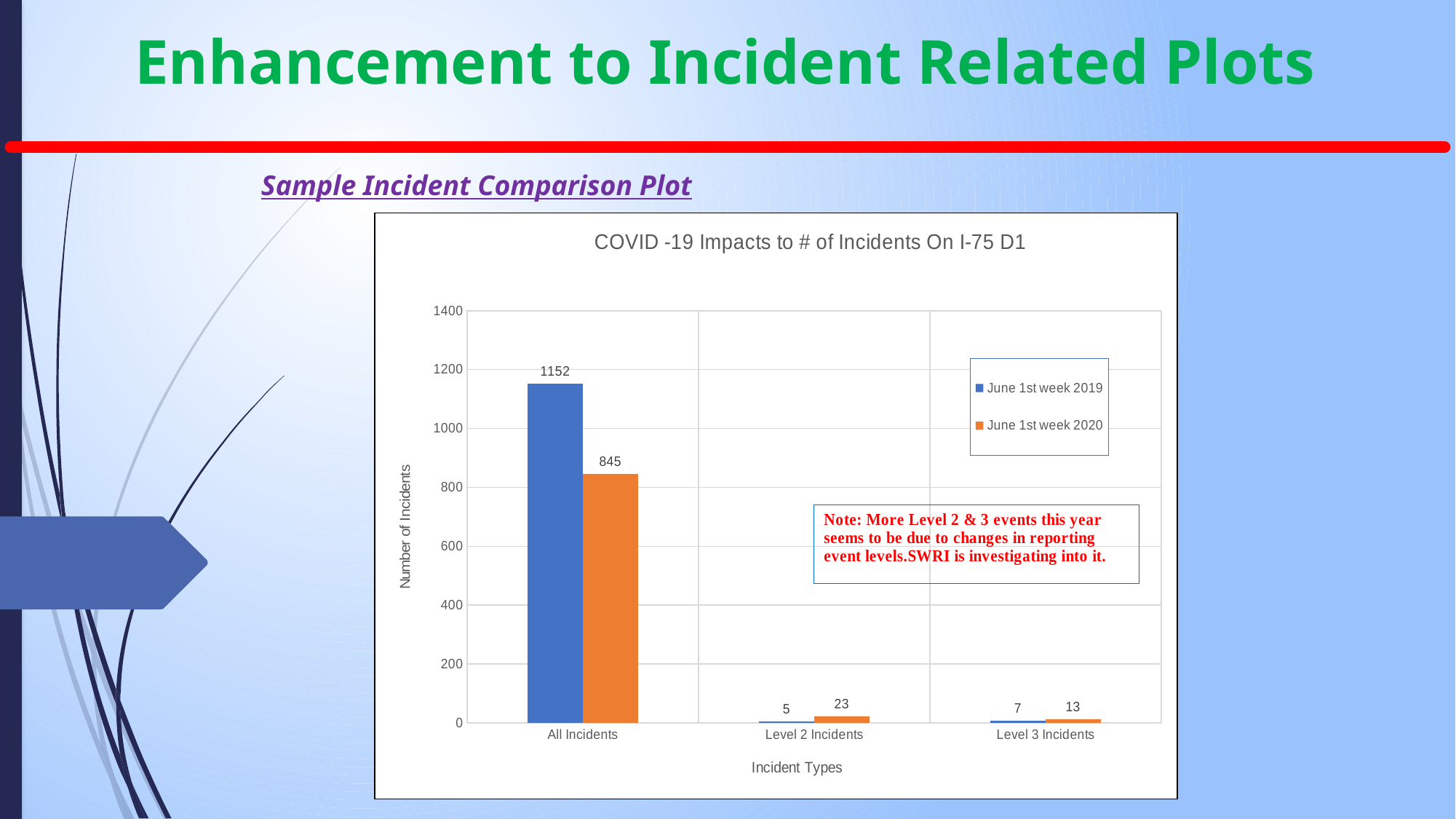
What kind of chart is shown on the slide? Bar chart For Level 2 Incidents, which series has the larger value, June 1st week 2019 or June 1st week 2020? June 1st week 2020 How many series does the legend list? 2 Which incident type has the highest value for June 1st week 2019? All Incidents What is the value for Level 2 Incidents in June 1st week 2020? 23 How many incident types are shown on the x axis? 3 What is the difference between the June 1st week 2019 and June 1st week 2020 values for All Incidents? 307 Is the value for All Incidents in June 1st week 2020 greater or less than 1000? less Which incident type has the lowest value for June 1st week 2020? Level 3 Incidents What is the value for Level 3 Incidents in June 1st week 2019? 7 What is the value for All Incidents in June 1st week 2019? 1152 What is the value for All Incidents in June 1st week 2020? 845